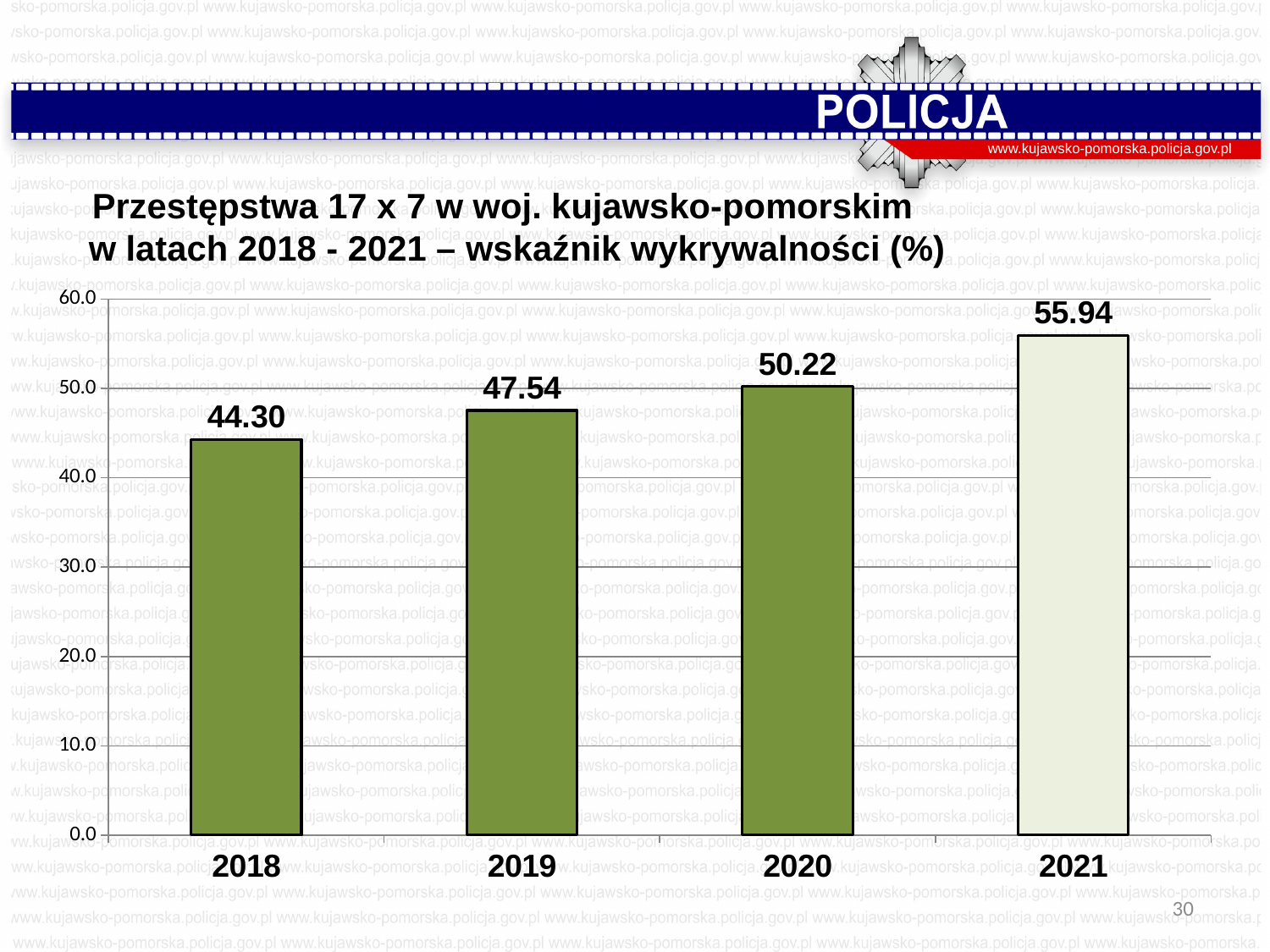
What is the value shown for 2020? 50.22 What is the detection rate value shown for 2018? 44.30 What is the difference between the values for 2020 and 2019? 2.68 What kind of chart is shown on the slide? bar chart Do the values rise or fall from 2018 to 2021? rise Which year has the lowest value? 2018 What is the value shown for 2021? 55.94 What is the difference between the values for 2021 and 2018? 11.64 Which year has the highest value? 2021 How many years are shown on the chart? 4 Is the value for 2019 greater or less than 50.0? less Which is larger, the value for 2019 or the value for 2020? 2020